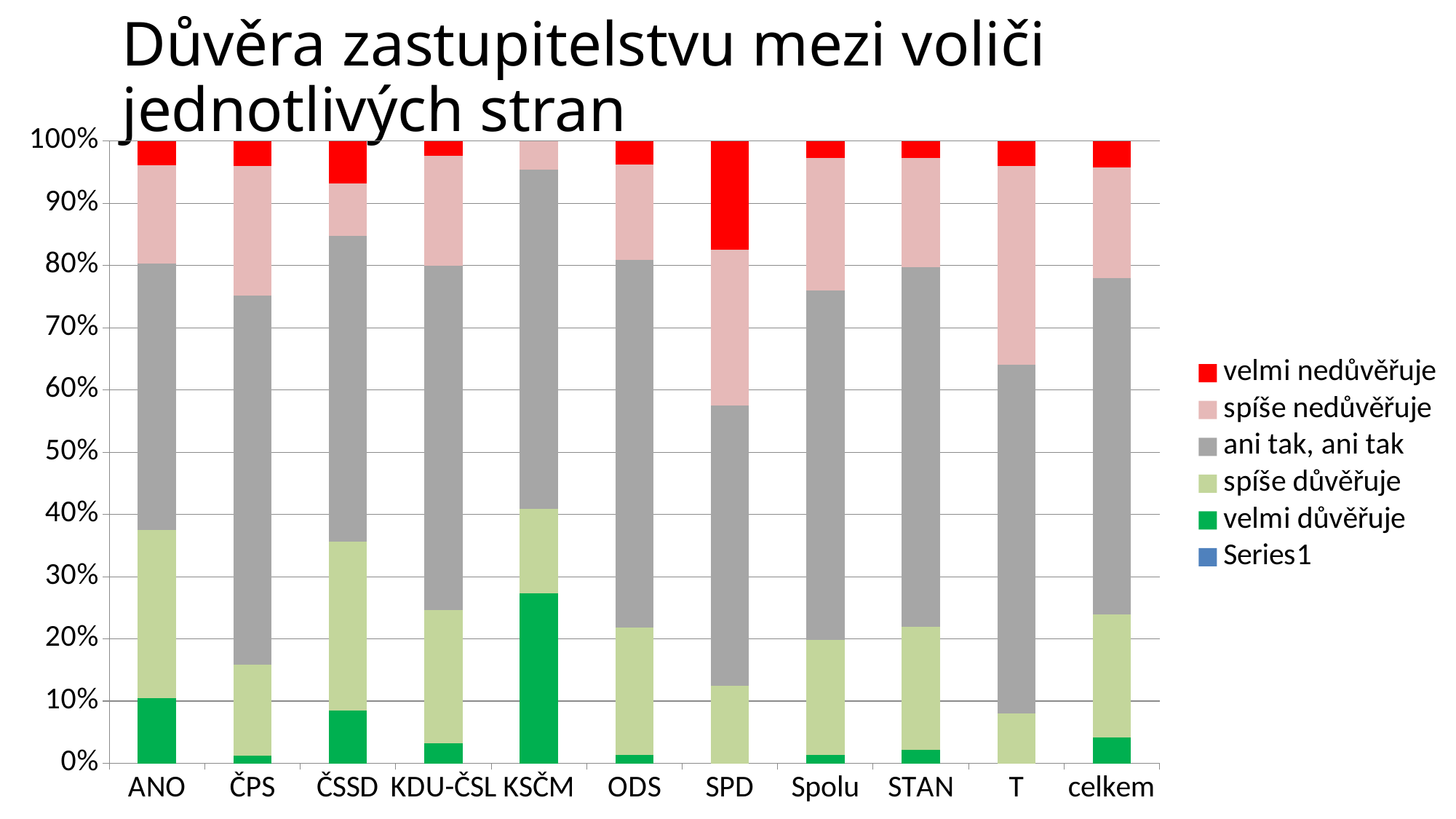
What type of chart is shown on the slide? stacked bar chart How many parties/categories are shown along the x axis? 11 What is the title of the chart? Důvěra zastupitelstvu mezi voliči jednotlivých stran Which category has the largest 'velmi nedůvěřuje' (red) segment? SPD Is the 'velmi důvěřuje' value for ANO greater or less than 20%? less Which category has the largest 'velmi důvěřuje' (dark green) segment? KSČM Which colour represents 'ani tak, ani tak' in the legend? grey Which has a larger 'velmi důvěřuje' segment, KSČM or ANO? KSČM Is the 'velmi důvěřuje' value for KSČM greater or less than 20%? greater How many series does the legend list? 6 Which has a larger 'velmi nedůvěřuje' segment, SPD or ANO? SPD What does each stacked bar total on the y axis? 100%